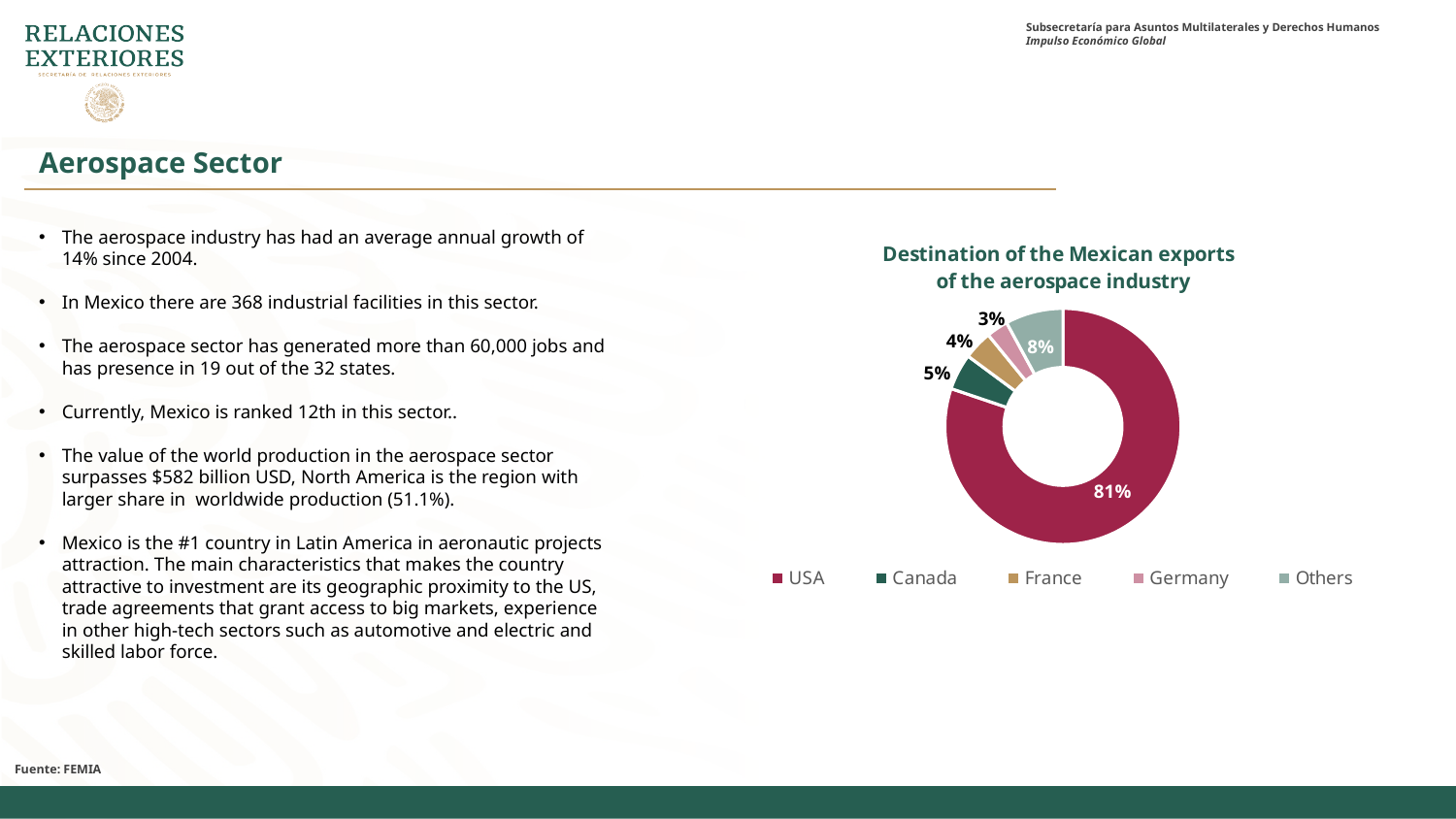
What is the title of the chart on the slide? Destination of the Mexican exports of the aerospace industry How many destination categories does the chart show? 5 Which has a larger share of Mexican aerospace exports, Canada or France? Canada What share of Mexican aerospace exports goes to Germany? 3% Which destination has the largest share of Mexican aerospace exports? USA What share of Mexican aerospace exports goes to the USA? 81% What kind of chart is used to show the destination of Mexican aerospace exports? doughnut chart What share of Mexican aerospace exports goes to Canada? 5% What share of Mexican aerospace exports goes to Others? 8% What share of Mexican aerospace exports goes to France? 4% Which destination has the smallest share of Mexican aerospace exports? Germany What is the difference in percentage points between the USA share and the Others share? 73